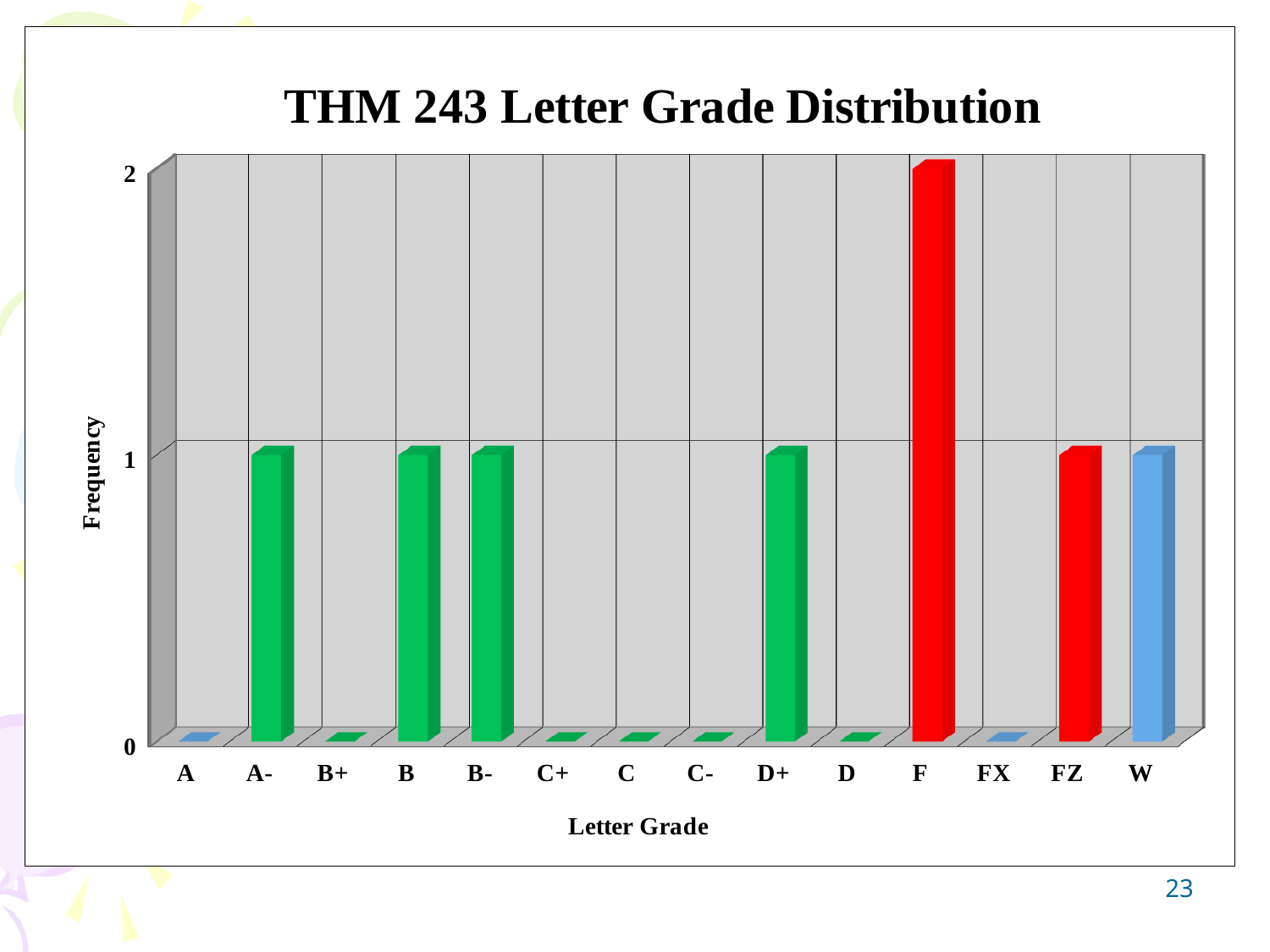
What is the frequency for the letter grade W? 1 What type of chart is shown on the slide? Bar chart What is the label of the y axis? Frequency What is the frequency for the letter grade F? 2 What is the frequency for the letter grade B? 1 How many letter grades have a frequency of 1? 6 How many letter grade categories are shown on the x axis? 14 What is the title of the chart? THM 243 Letter Grade Distribution Which letter grade has the highest frequency? F What is the difference in frequency between F and FZ? 1 What is the frequency for the letter grade C? 0 Which has a higher frequency, A- or A? A-